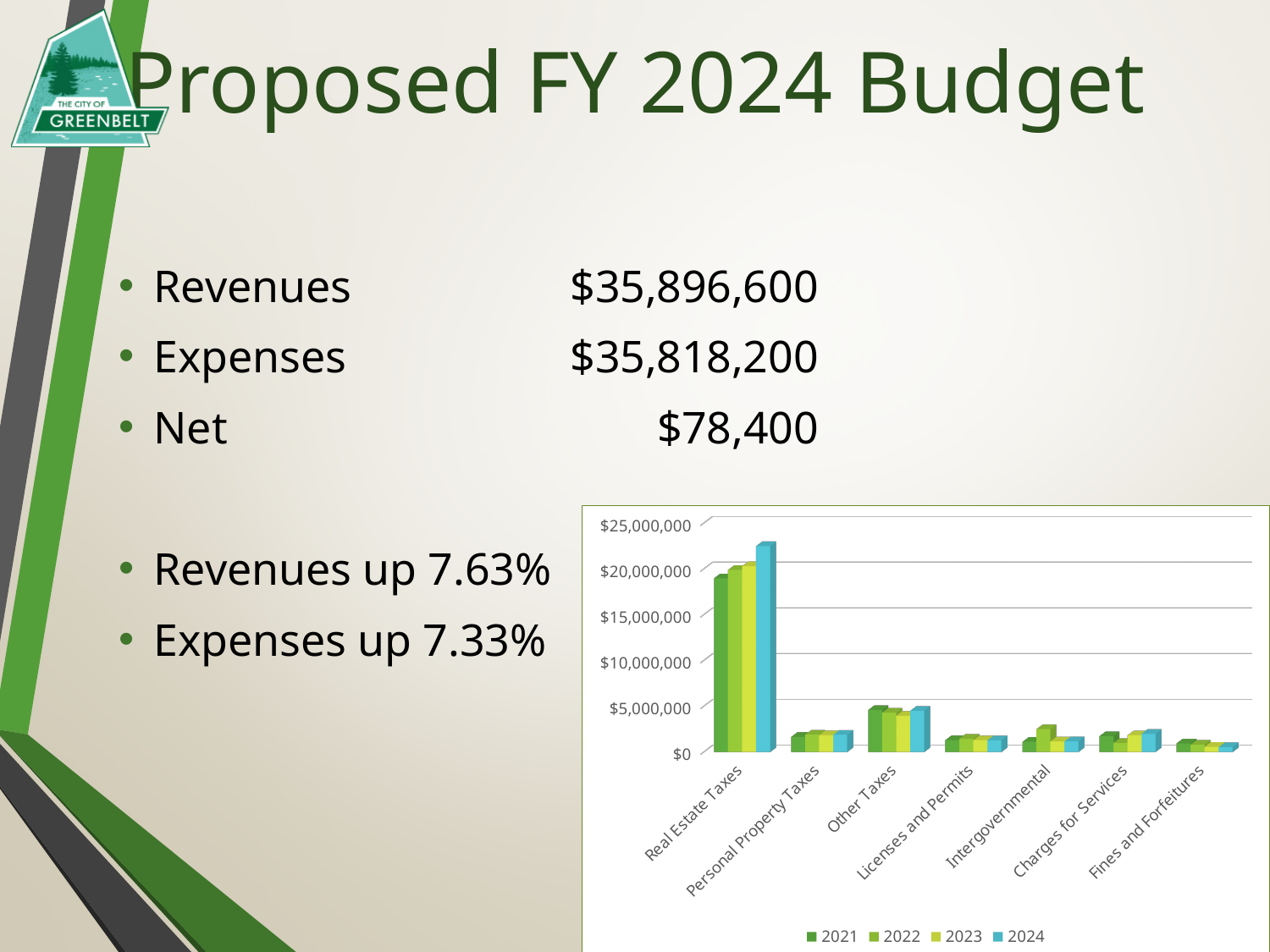
Which category appears first on the x axis of the chart? Real Estate Taxes How many series does the chart's legend list? 4 Which category has the lowest values in the chart? Fines and Forfeitures Which is larger in 2024, Real Estate Taxes or Other Taxes? Real Estate Taxes Which years are listed in the chart's legend? 2021, 2022, 2023, 2024 Do the Real Estate Taxes values rise or fall from 2021 to 2024? rise Is the 2021 value for Real Estate Taxes greater or less than $15,000,000? greater Which category has the highest values in the chart? Real Estate Taxes Is the 2024 value for Real Estate Taxes greater or less than $20,000,000? greater What kind of chart is shown on the slide? bar chart How many categories are shown on the x axis of the chart? 7 Is the 2024 value for Personal Property Taxes greater or less than $5,000,000? less